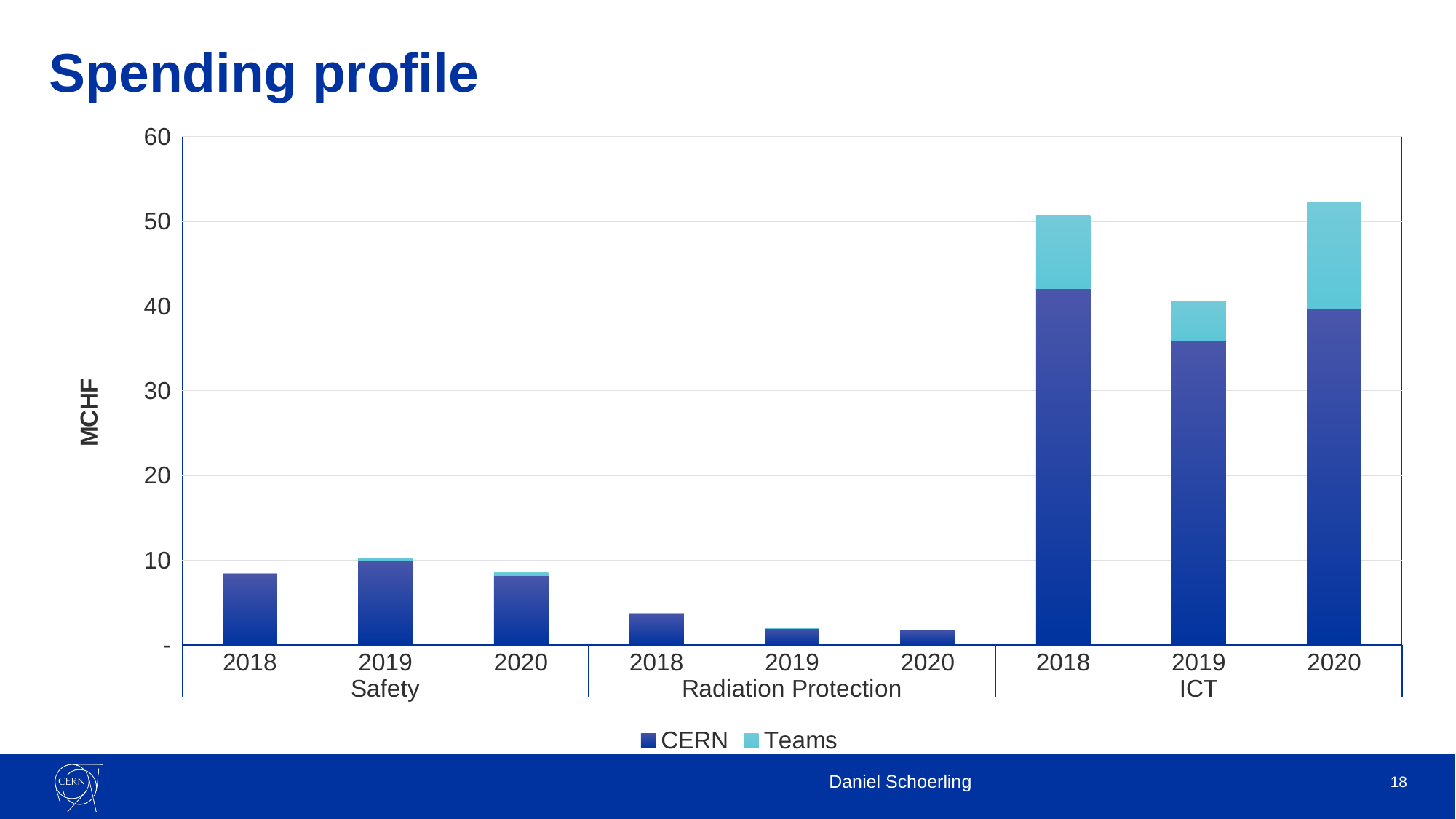
What is the label on the vertical axis? MCHF Is the CERN portion of the ICT 2019 bar greater or less than 40? less How many series does the legend list? 2 How many bars are plotted in the chart? 9 Is the total value for Safety 2018 greater or less than 10? less Which is larger, the total for ICT 2018 or the total for Safety 2018? ICT 2018 Which is larger, the total for Radiation Protection 2018 or Radiation Protection 2019? Radiation Protection 2018 Which three groups of categories are shown along the x axis? Safety, Radiation Protection, ICT Do the Radiation Protection totals rise or fall from 2018 to 2020? fall What kind of chart is shown on the slide? Stacked bar chart Is the CERN portion of the ICT 2018 bar greater or less than 40? greater